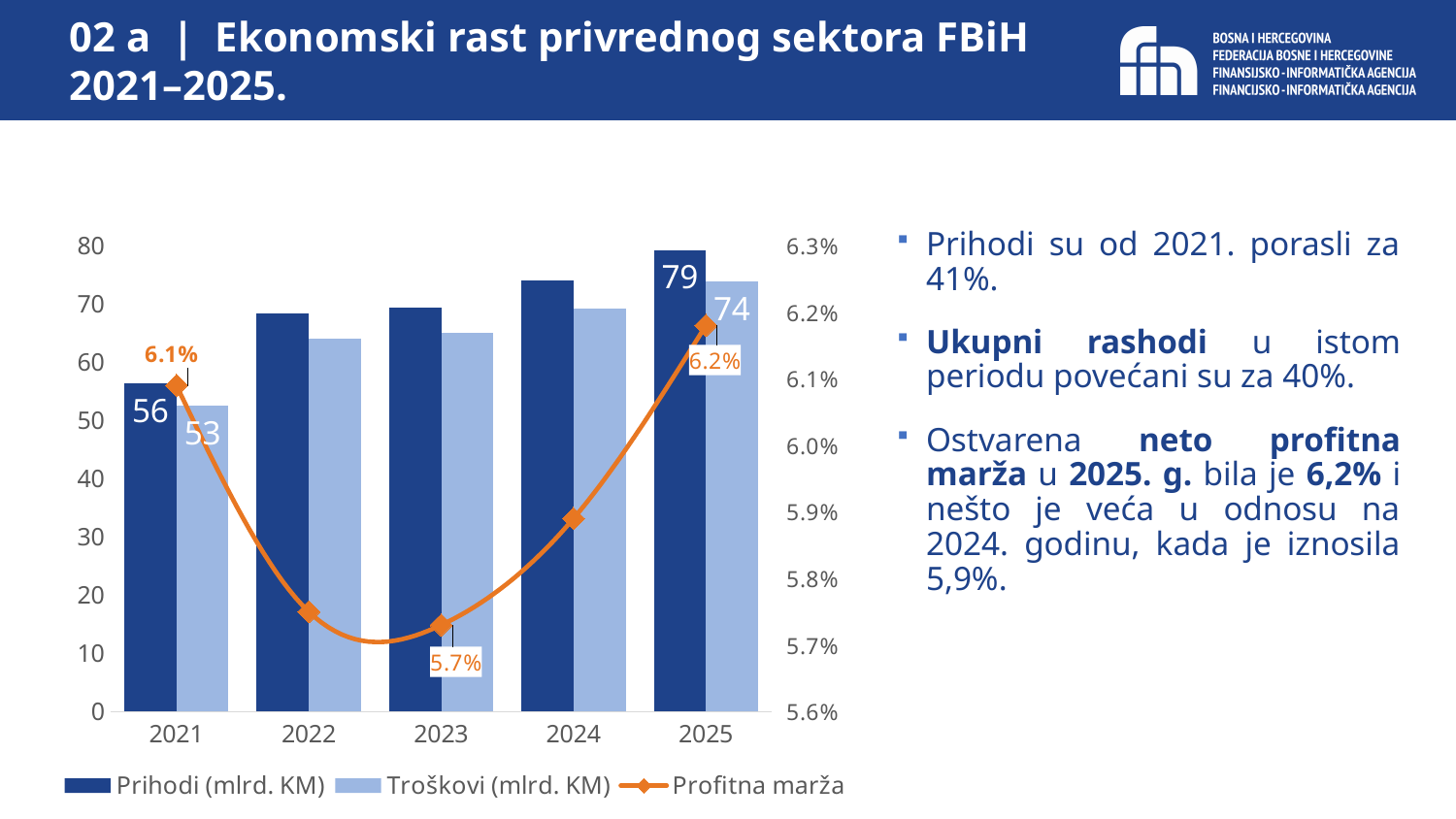
What is the Profitna marža for 2025? 6.2% In which year is the Profitna marža the lowest? 2023 How many years are shown on the x axis? 5 What is the difference between Prihodi and Troškovi in 2025? 5 What is the value of Troškovi (mlrd. KM) for 2025? 74 What is the value of Prihodi (mlrd. KM) for 2021? 56 What is the Profitna marža for 2023? 5.7% How many series does the legend list? 3 By how much did Prihodi (mlrd. KM) increase from 2021 to 2025? 23 In which year is Prihodi (mlrd. KM) the highest? 2025 Do the Prihodi (mlrd. KM) values rise or fall from 2021 to 2025? rise Is the value of Prihodi (mlrd. KM) for 2022 greater or less than 60? greater